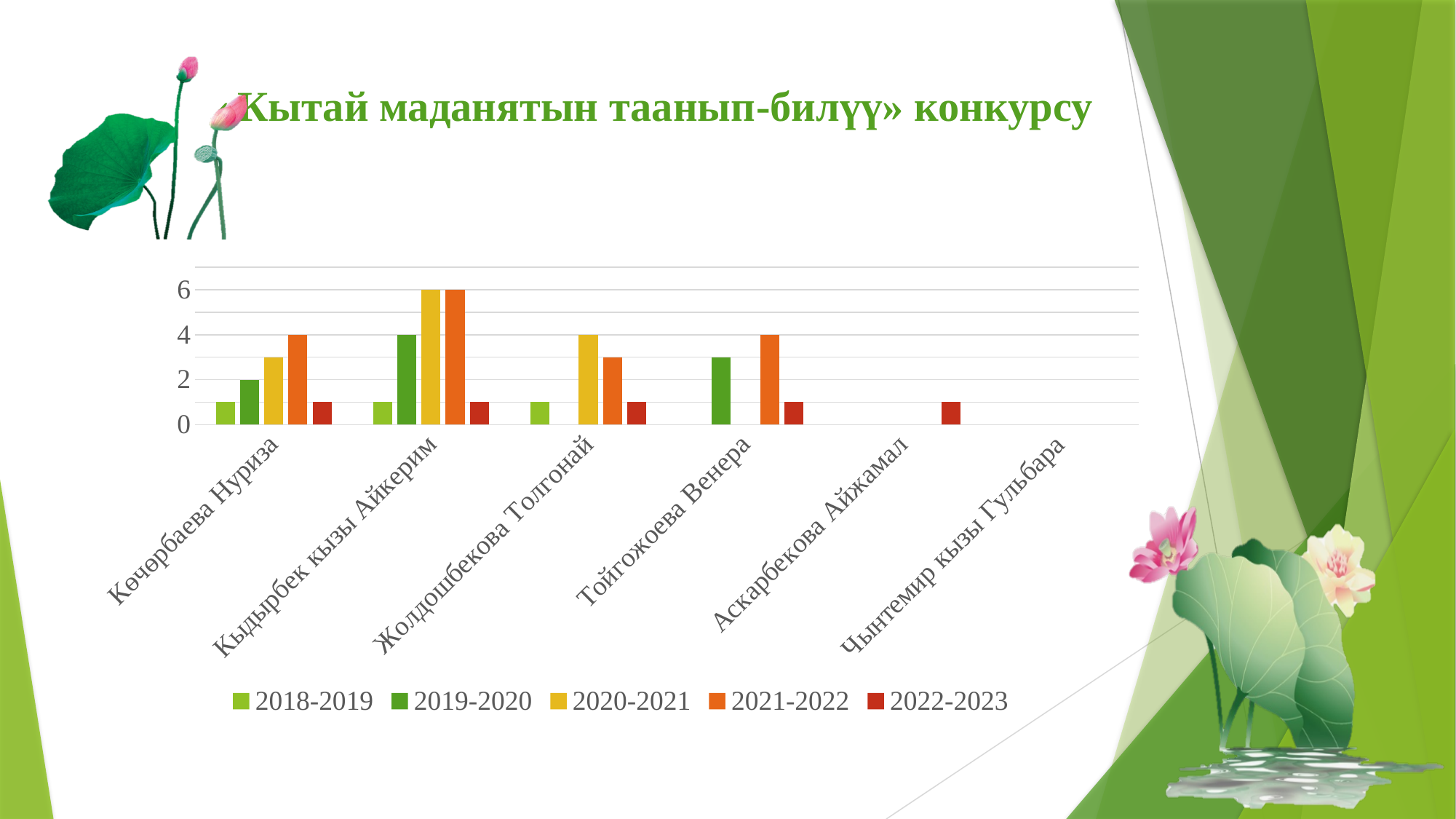
What is the value for Тойгожоева Венера in 2021-2022? 4 What is the difference between the 2021-2022 values for Кыдырбек кызы Айкерим and Көчөрбаева Нуриза? 2 Which is larger in 2020-2021: the value for Кыдырбек кызы Айкерим or for Жолдошбекова Толгонай? Кыдырбек кызы Айкерим What is the value for Кыдырбек кызы Айкерим in 2020-2021? 6 Which category has the highest value in the 2021-2022 series? Кыдырбек кызы Айкерим What kind of chart is shown on the slide? bar chart Is the 2019-2020 value for Тойгожоева Венера greater or less than 4? less What is the value for Көчөрбаева Нуриза in 2021-2022? 4 How many series does the legend list? 5 What is the value for Кыдырбек кызы Айкерим in 2019-2020? 4 How many categories (names) are shown on the x axis? 6 What is the value for Көчөрбаева Нуриза in 2019-2020? 2